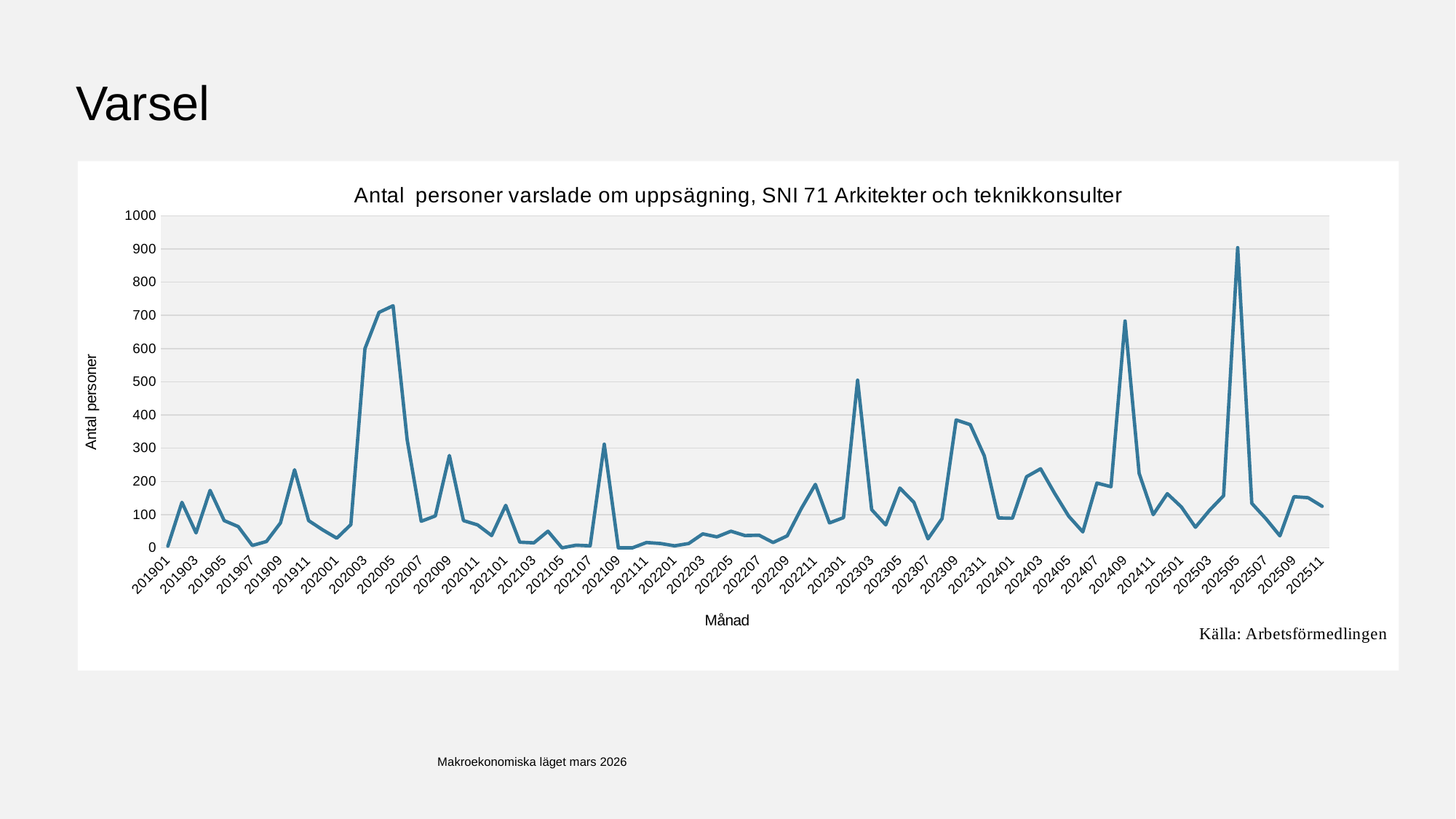
Is the value for 202109 greater or less than 200? less Is the value for 202409 greater or less than 600? greater What kind of chart is shown on the slide? line chart Is the value for 202201 greater or less than 100? less Which is larger, the value for 202505 or the value for 202005? 202505 Which is larger, the value for 202409 or the value for 202301? 202409 Which month has the highest value on the chart? 202505 What is the title of the chart? Antal personer varslade om uppsägning, SNI 71 Arkitekter och teknikkonsulter What is the label of the vertical axis? Antal personer